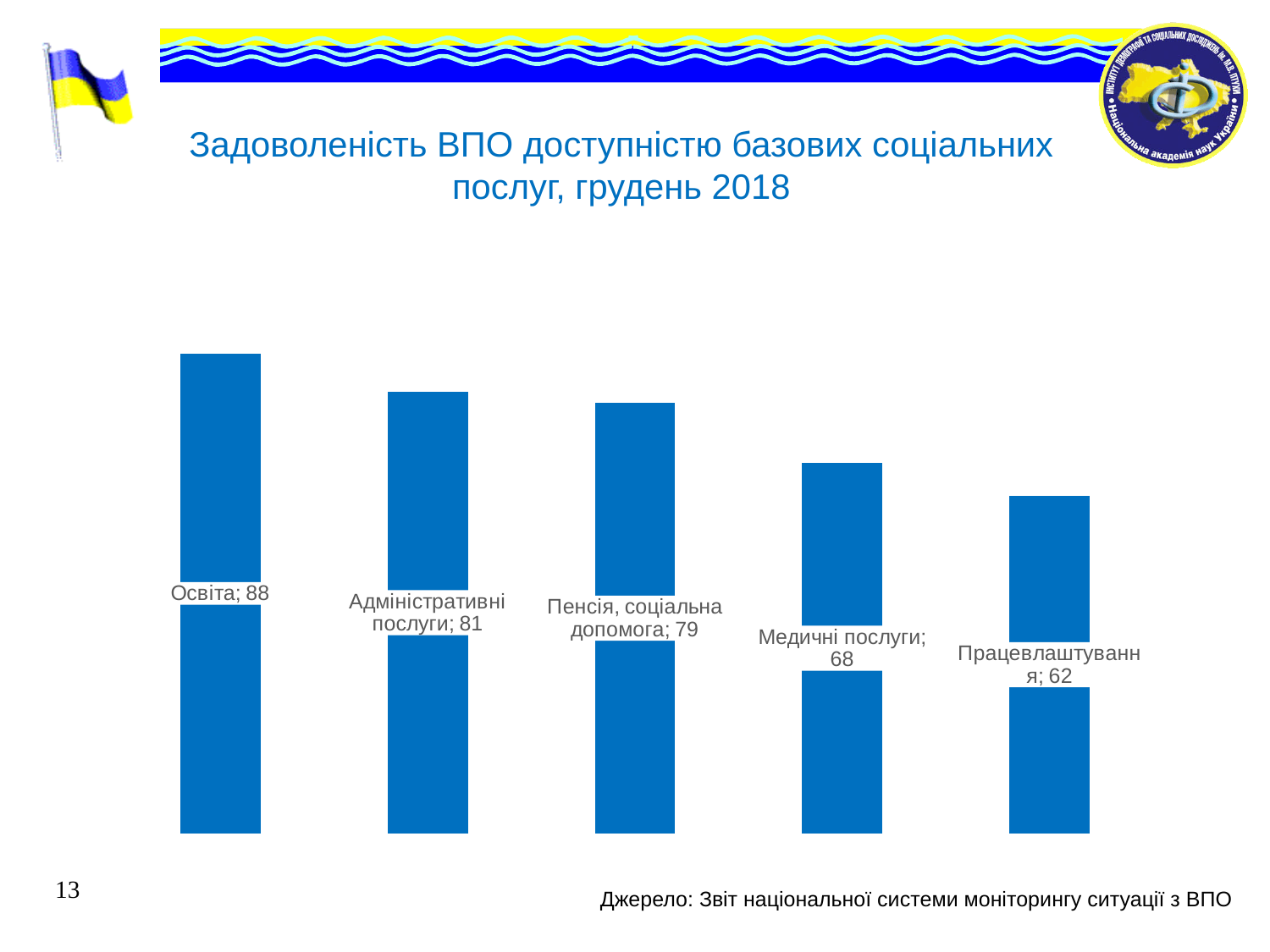
Which category has the lowest value? Працевлаштування Which is larger, the value for Медичні послуги or the value for Пенсія, соціальна допомога? Пенсія, соціальна допомога What is the value for Освіта? 88 What is the value for Адміністративні послуги? 81 What is the value for Медичні послуги? 68 Do the values rise or fall from left to right across the categories? fall How many categories are shown in the chart? 5 What is the difference between the values for Освіта and Працевлаштування? 26 Which category has the highest value? Освіта What kind of chart is shown on the slide? bar chart What is the value for Пенсія, соціальна допомога? 79 What is the value for Працевлаштування? 62